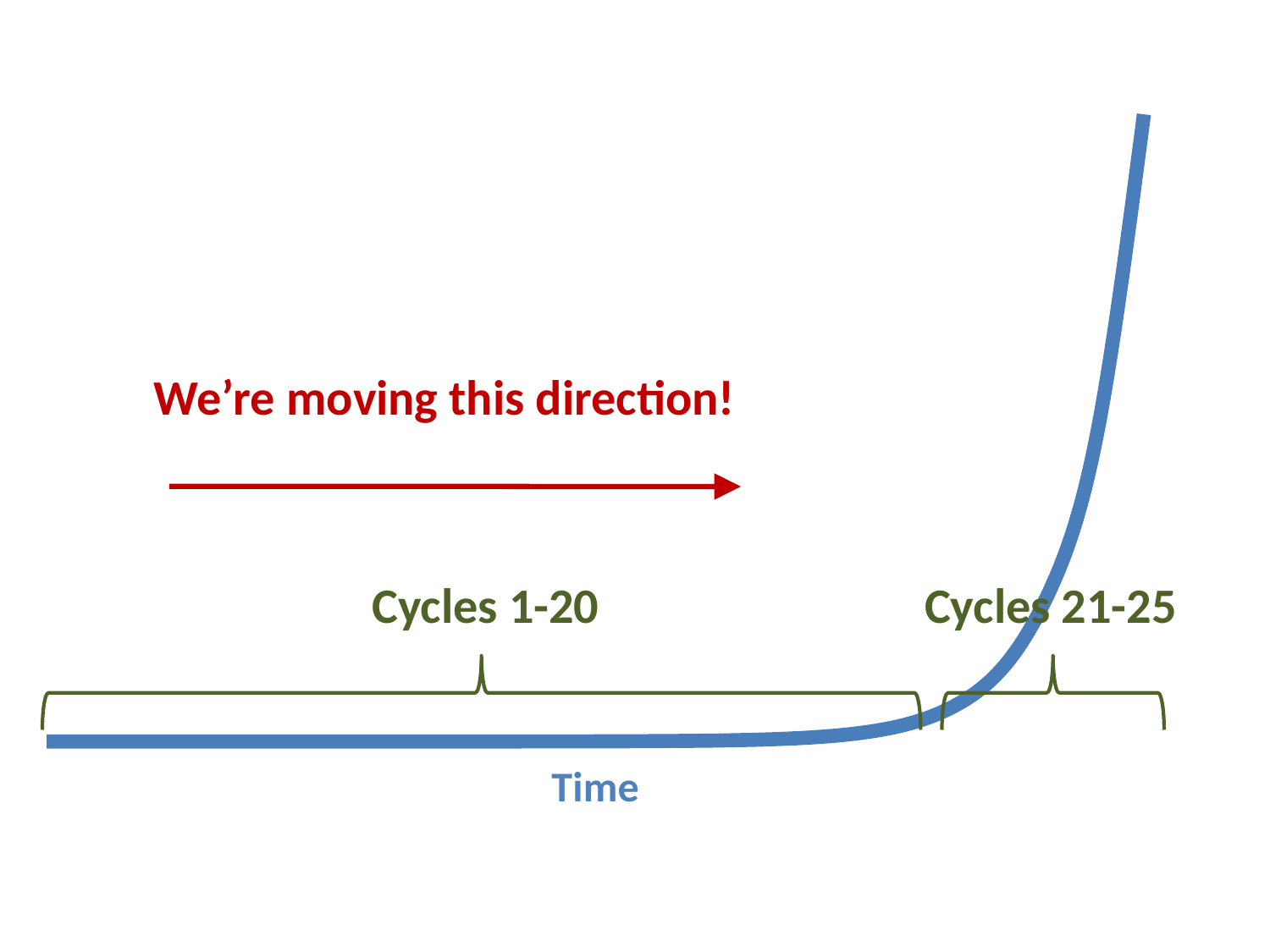
What is the label on the x axis of the chart? Time What kind of chart is shown on the slide? line chart How many lines are plotted on the chart? 1 What does the red annotation above the arrow say? We're moving this direction! In which bracketed range, Cycles 1-20 or Cycles 21-25, is the line nearly flat? Cycles 1-20 How many bracketed cycle ranges are marked along the x axis? 2 In which bracketed range, Cycles 1-20 or Cycles 21-25, does the line rise steeply? Cycles 21-25 Is the line higher at the right end of the chart or at the left end? right end Does the plotted line rise or fall as it moves along the x axis? rise